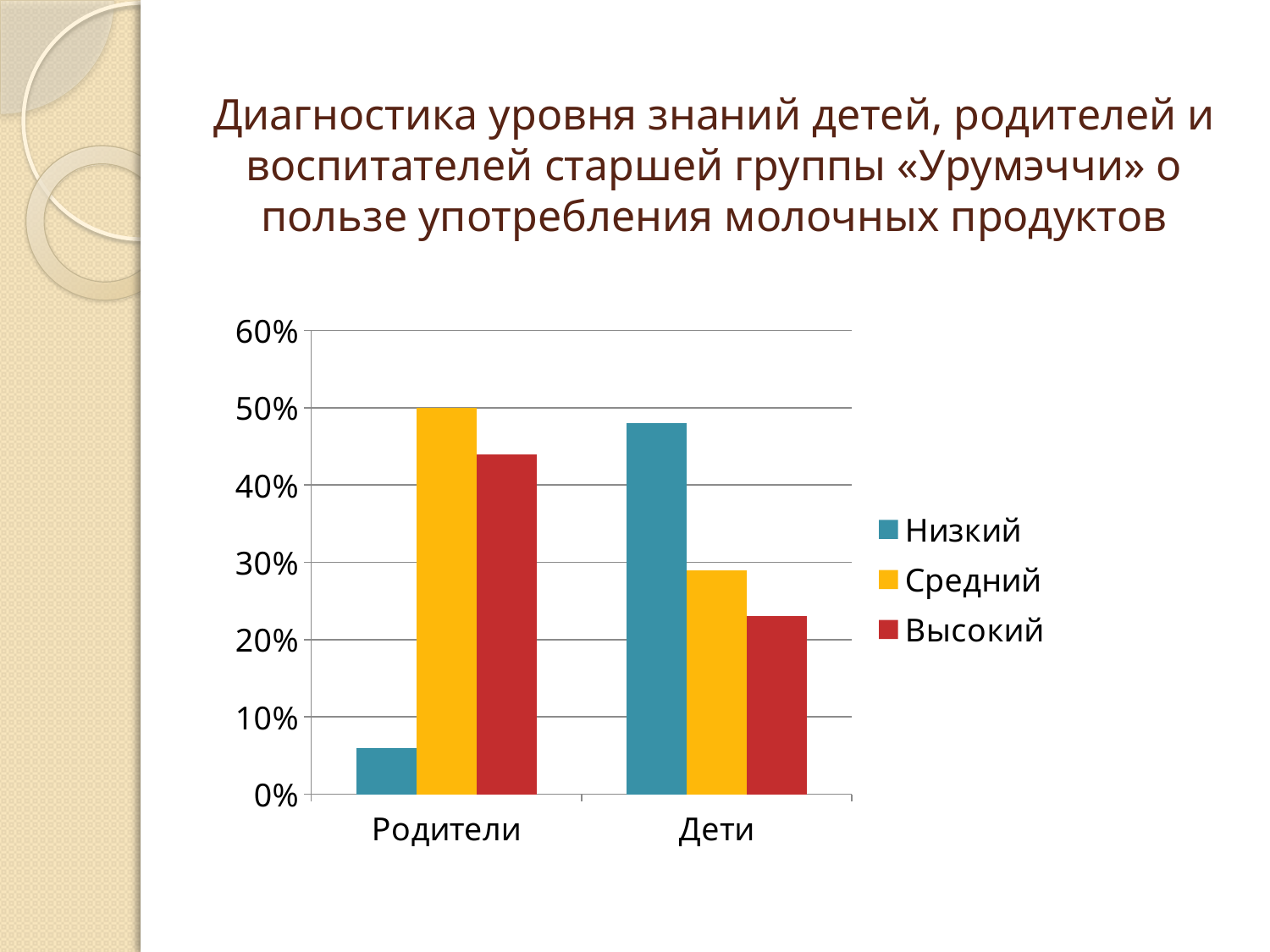
Is the value of Низкий for Дети greater or less than 40%? greater What is the value of Средний for Родители? 50% Which is larger: Низкий for Родители or Низкий for Дети? Низкий for Дети Which series has the highest value for Родители? Средний Is the value of Высокий for Дети greater or less than 20%? greater Is the value of Высокий for Родители greater or less than 40%? greater How many categories are shown on the x axis? 2 How many series does the legend list? 3 Which series has the lowest value for Дети? Высокий What kind of chart is shown on the slide? bar chart